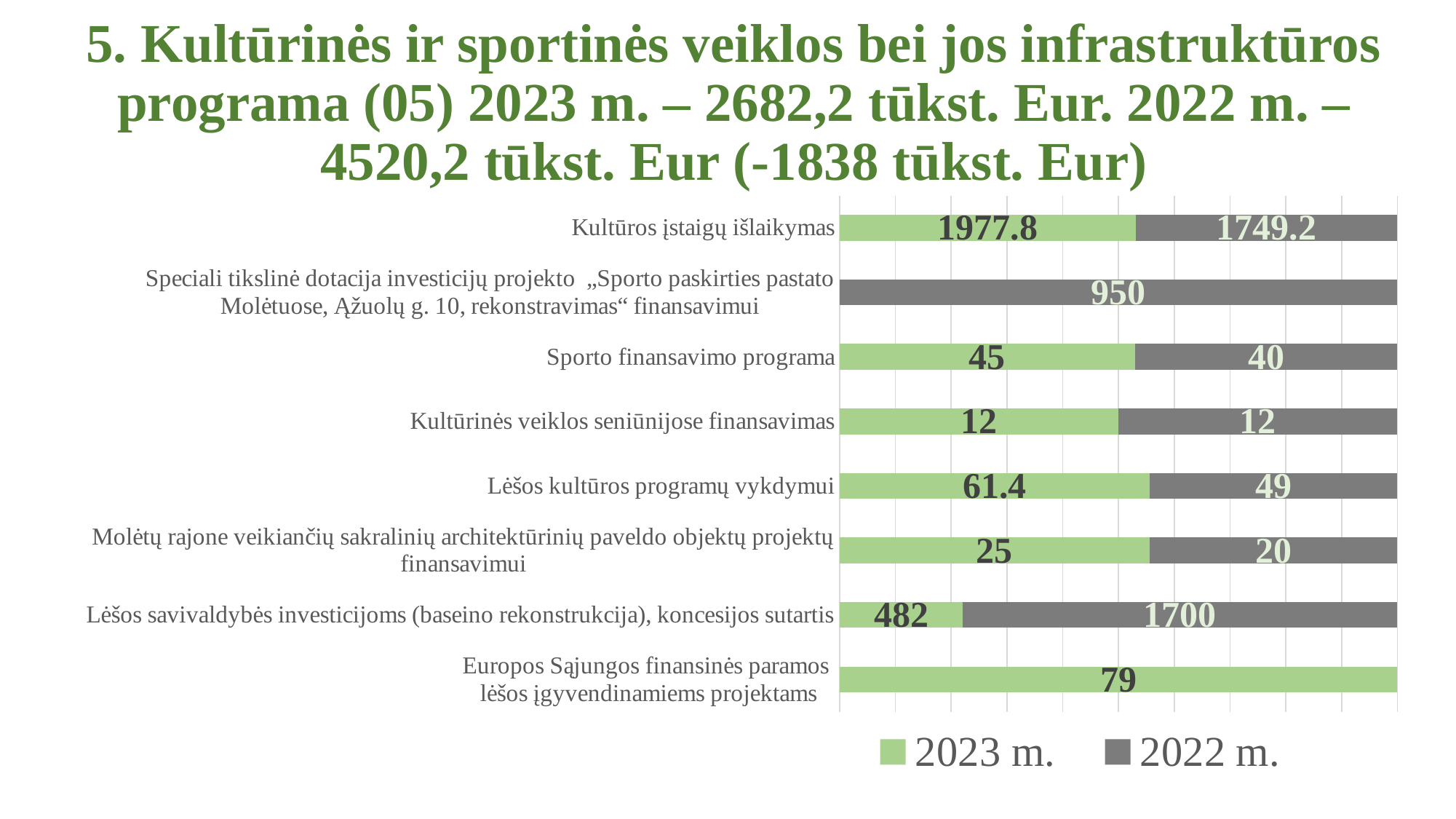
What is the 2022 m. value for Lėšos savivaldybės investicijoms (baseino rekonstrukcija), koncesijos sutartis? 1700 What kind of chart is shown on the slide? Bar chart What is the 2023 m. value for Kultūros įstaigų išlaikymas? 1977.8 What is the difference between the 2022 m. and 2023 m. values for Lėšos savivaldybės investicijoms (baseino rekonstrukcija), koncesijos sutartis? 1218 How many series does the legend list? 2 What is the 2022 m. value for Speciali tikslinė dotacija investicijų projekto „Sporto paskirties pastato Molėtuose, Ąžuolų g. 10, rekonstravimas“ finansavimui? 950 What is the 2023 m. value for Lėšos kultūros programų vykdymui? 61.4 What is the total of the 2023 m. and 2022 m. values for Kultūros įstaigų išlaikymas? 3727 Which category has the highest 2023 m. value? Kultūros įstaigų išlaikymas Which category has the lowest 2022 m. value? Kultūrinės veiklos seniūnijose finansavimas How many categories are shown in the chart? 8 Which is larger for Sporto finansavimo programa, the 2023 m. value or the 2022 m. value? 2023 m.